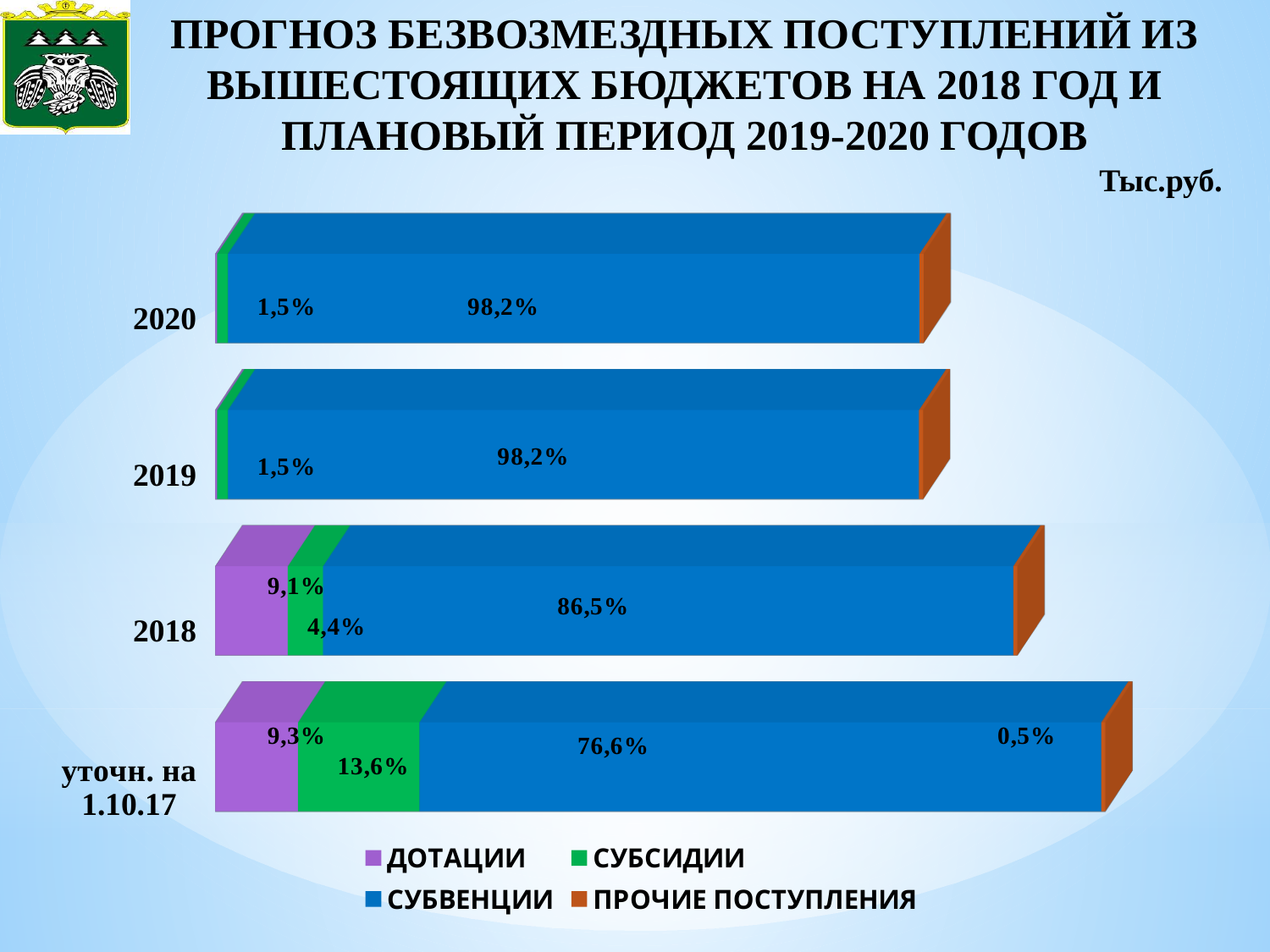
What is the share of ДОТАЦИИ for 2018? 9,1% What kind of chart is shown on the slide? Stacked bar chart What is the share of СУБСИДИИ for уточн. на 1.10.17? 13,6% By how many percentage points does the СУБСИДИИ share for уточн. на 1.10.17 exceed that for 2018? 9,2% What unit is indicated above the chart? Тыс.руб. How many series does the legend list? 4 What is the share of ПРОЧИЕ ПОСТУПЛЕНИЯ for уточн. на 1.10.17? 0,5% What is the share of СУБВЕНЦИИ for 2019? 98,2% Which has the larger ДОТАЦИИ share: 2018 or уточн. на 1.10.17? уточн. на 1.10.17 How many categories (bars) are shown on the chart? 4 What is the share of СУБВЕНЦИИ for 2018? 86,5% Which category has the lowest share of СУБВЕНЦИИ? уточн. на 1.10.17